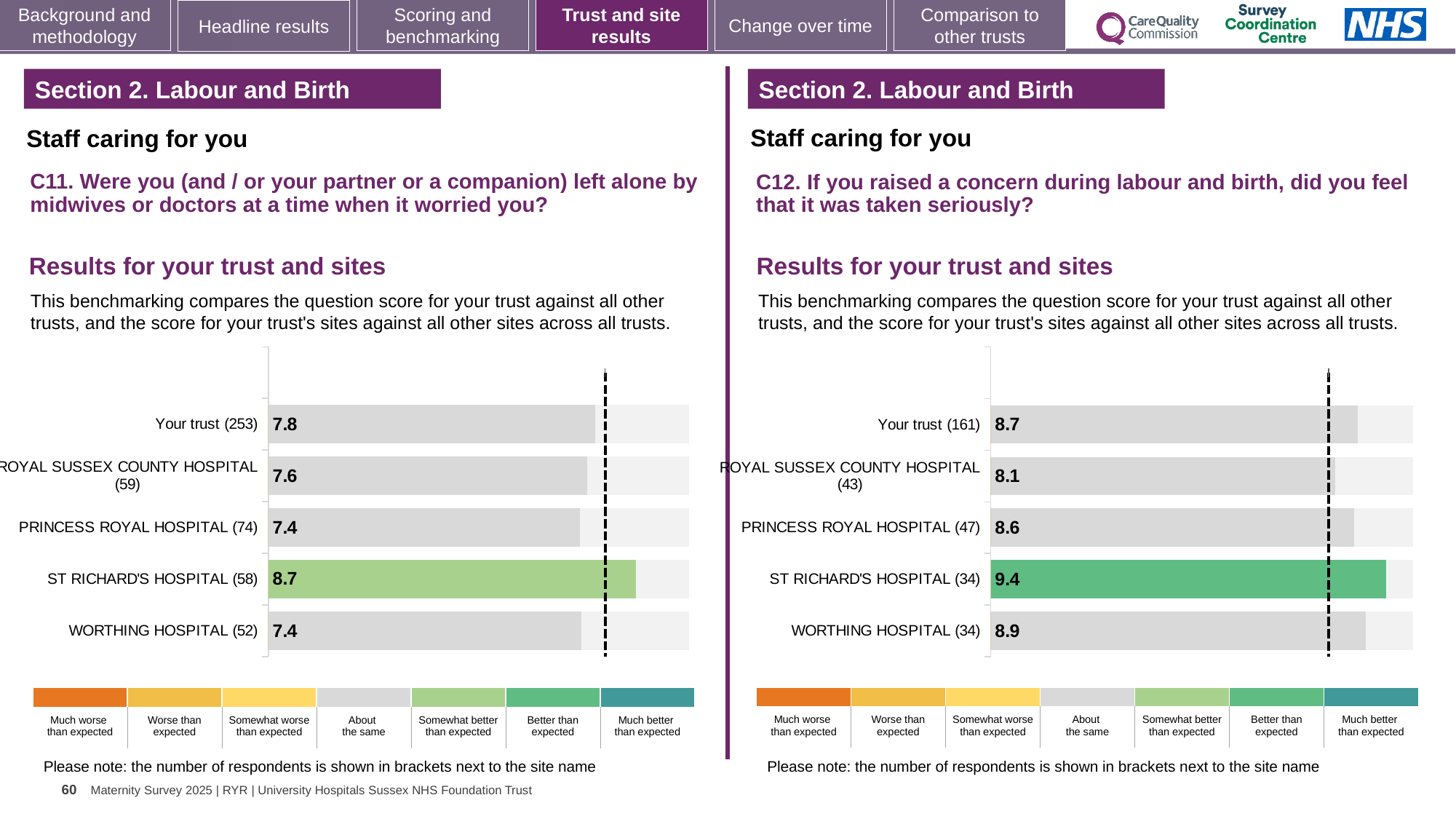
In the right chart (C12), what is the difference between the scores for ST RICHARD'S HOSPITAL and Your trust? 0.7 In the left chart (C11), how many respondents are shown in brackets for Your trust? 253 In the right chart (C12), what is the score for ROYAL SUSSEX COUNTY HOSPITAL? 8.1 In the left chart (C11), what is the difference between the scores for Your trust and PRINCESS ROYAL HOSPITAL? 0.4 In the left chart (C11), what is the score for Your trust? 7.8 In the left chart (C11), what is the score for ST RICHARD'S HOSPITAL? 8.7 What type of chart is used in the right chart (C12)? Bar chart In the left chart (C11), which site has the highest score? ST RICHARD'S HOSPITAL In the right chart (C12), which site has the lowest score? ROYAL SUSSEX COUNTY HOSPITAL How many bars are shown in the left chart (C11)? 5 In the right chart (C12), what is the score for WORTHING HOSPITAL? 8.9 In the right chart (C12), which has the higher score, PRINCESS ROYAL HOSPITAL or WORTHING HOSPITAL? WORTHING HOSPITAL